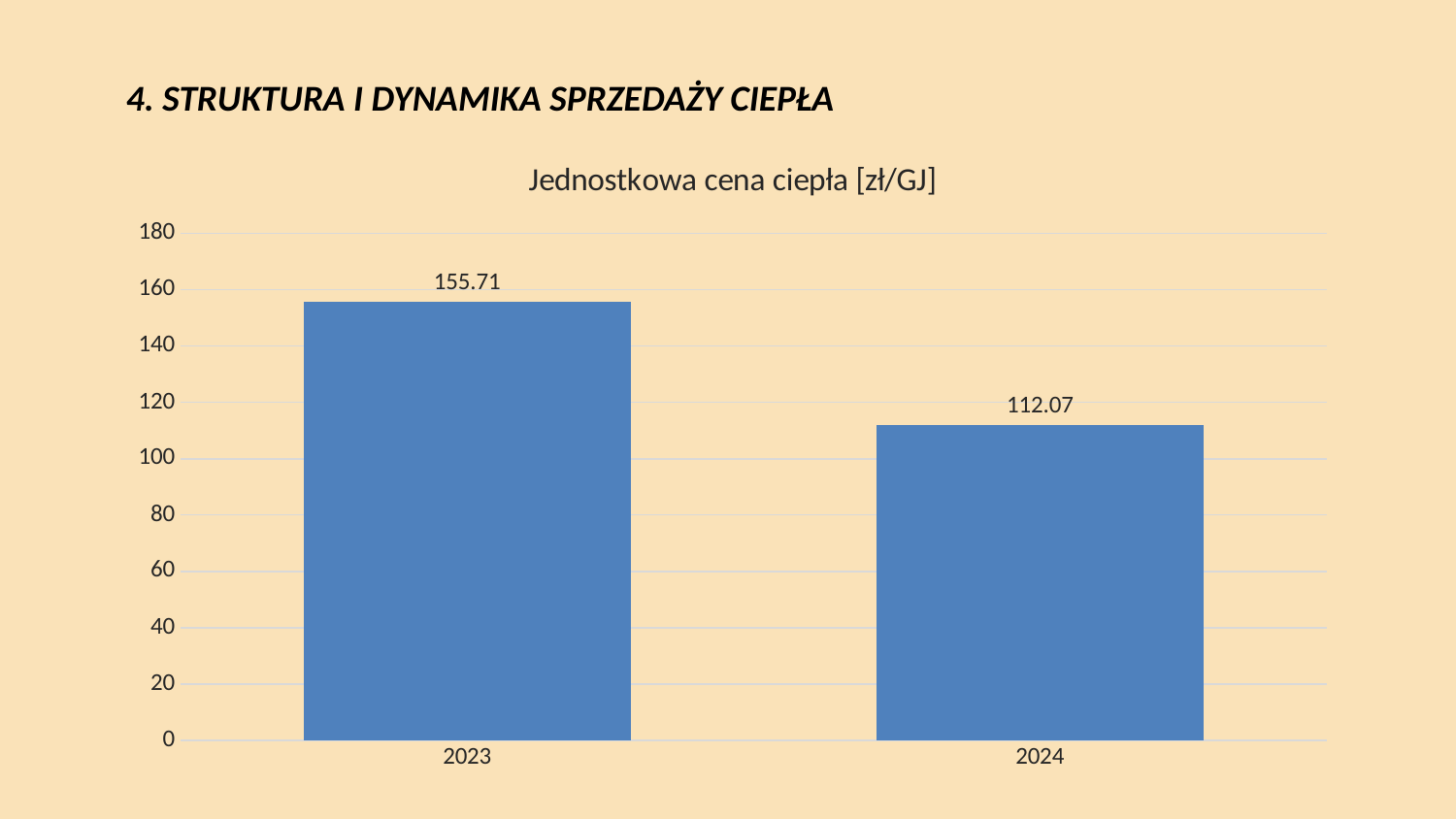
What is the value for 2023? 155.71 Is the value for 2023 greater or less than 140? greater Which is larger, the value for 2023 or the value for 2024? 2023 Which year has the highest value? 2023 Do the values rise or fall from 2023 to 2024? fall What kind of chart is shown on the slide? bar chart What is the difference between the values for 2023 and 2024? 43.64 What is the title of the chart? Jednostkowa cena ciepła [zł/GJ] Is the value for 2024 greater or less than 120? less Which year has the lowest value? 2024 What is the value for 2024? 112.07 How many categories are shown on the x axis? 2